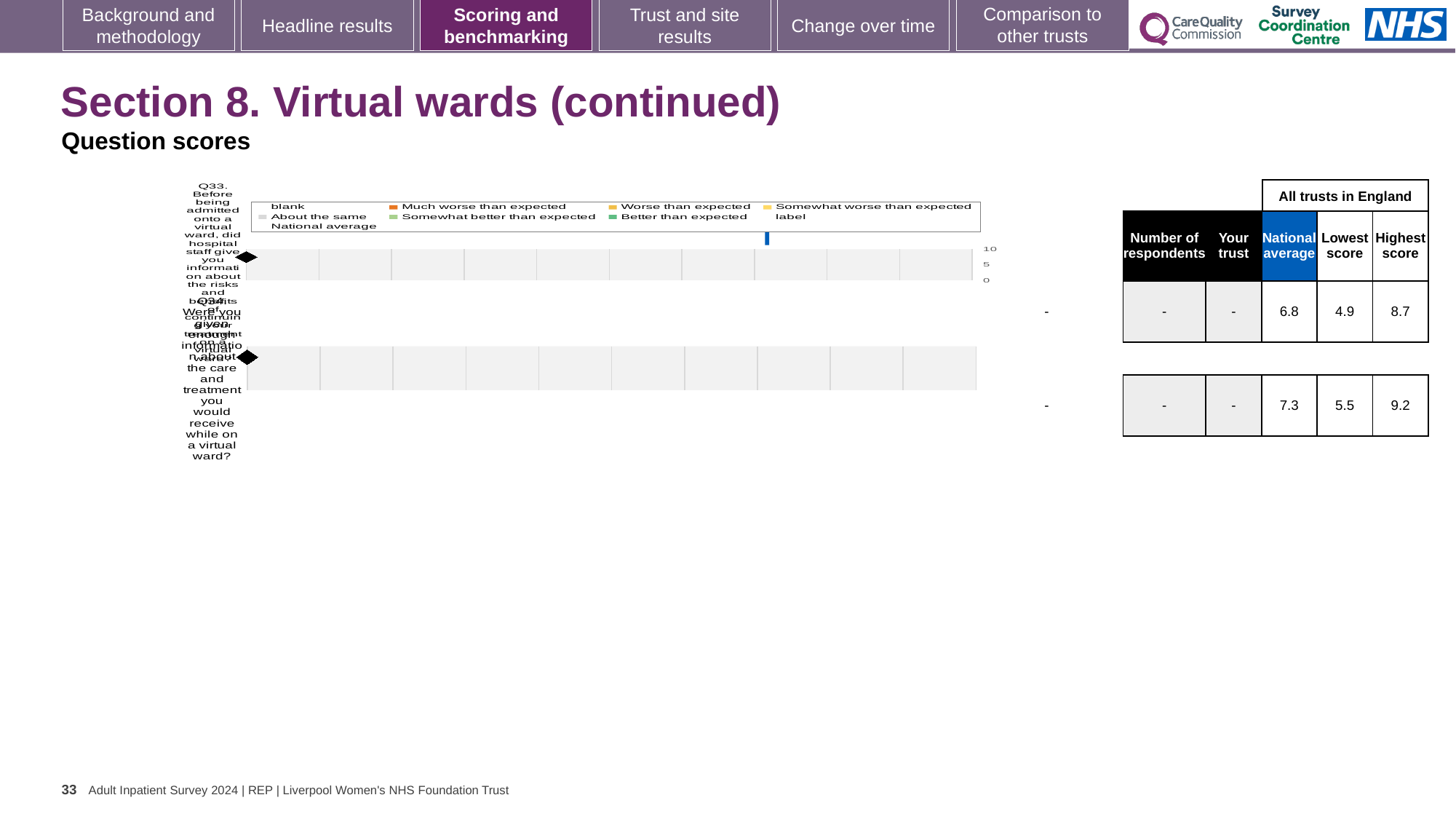
In the table next to the chart, what is the difference between the highest and lowest scores for Q34? 3.7 In the table next to the chart, which question has the higher national average, Q33 or Q34? Q34 In the table next to the chart, what is the highest score across all trusts in England for Q34? 9.2 What kind of chart is shown on the slide? bar chart What is the highest value shown on the chart's score axis? 10 In the table next to the chart, what is shown as the trust's own score for Q33? - In the table next to the chart, what is the national average score for Q33? 6.8 In the table next to the chart, what is the lowest score across all trusts in England for Q33? 4.9 How many questions (categories) are plotted on the chart? 2 In the table next to the chart, what is the national average score for Q34? 7.3 In the table next to the chart, what is the difference between the highest and lowest scores for Q33? 3.8 What is the heading above the National average, Lowest score and Highest score columns in the table? All trusts in England